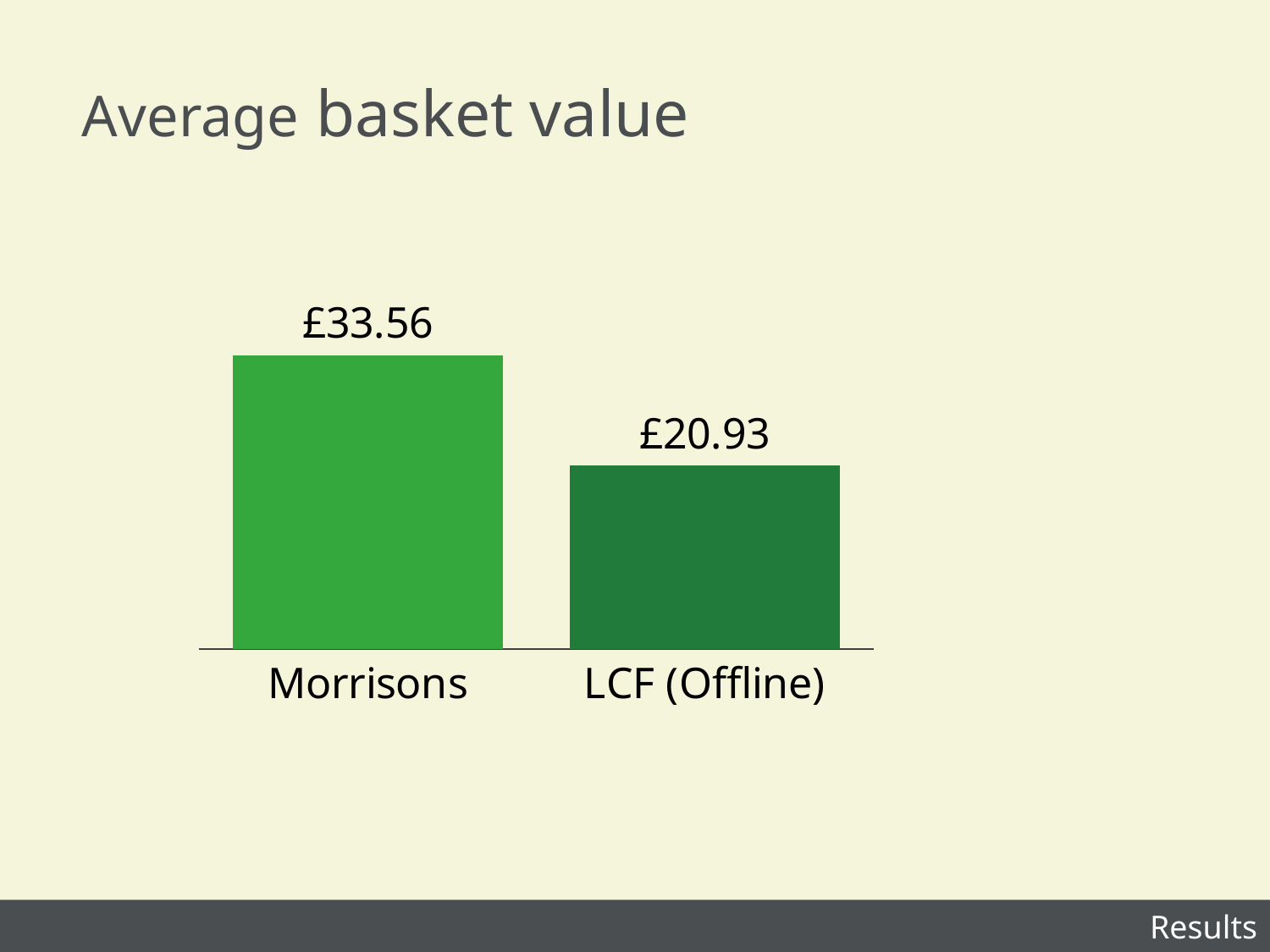
What is the average basket value for Morrisons? £33.56 What is the difference between the average basket value for Morrisons and for LCF (Offline)? £12.63 Which category has the highest average basket value? Morrisons Which category has the lowest average basket value? LCF (Offline) What is the title of the slide? Average basket value Which is larger, the average basket value for Morrisons or for LCF (Offline)? Morrisons How many categories are shown in the chart? 2 What kind of chart is shown on the slide? Bar chart What colour is the bar for LCF (Offline)? Dark green What is the average basket value for LCF (Offline)? £20.93